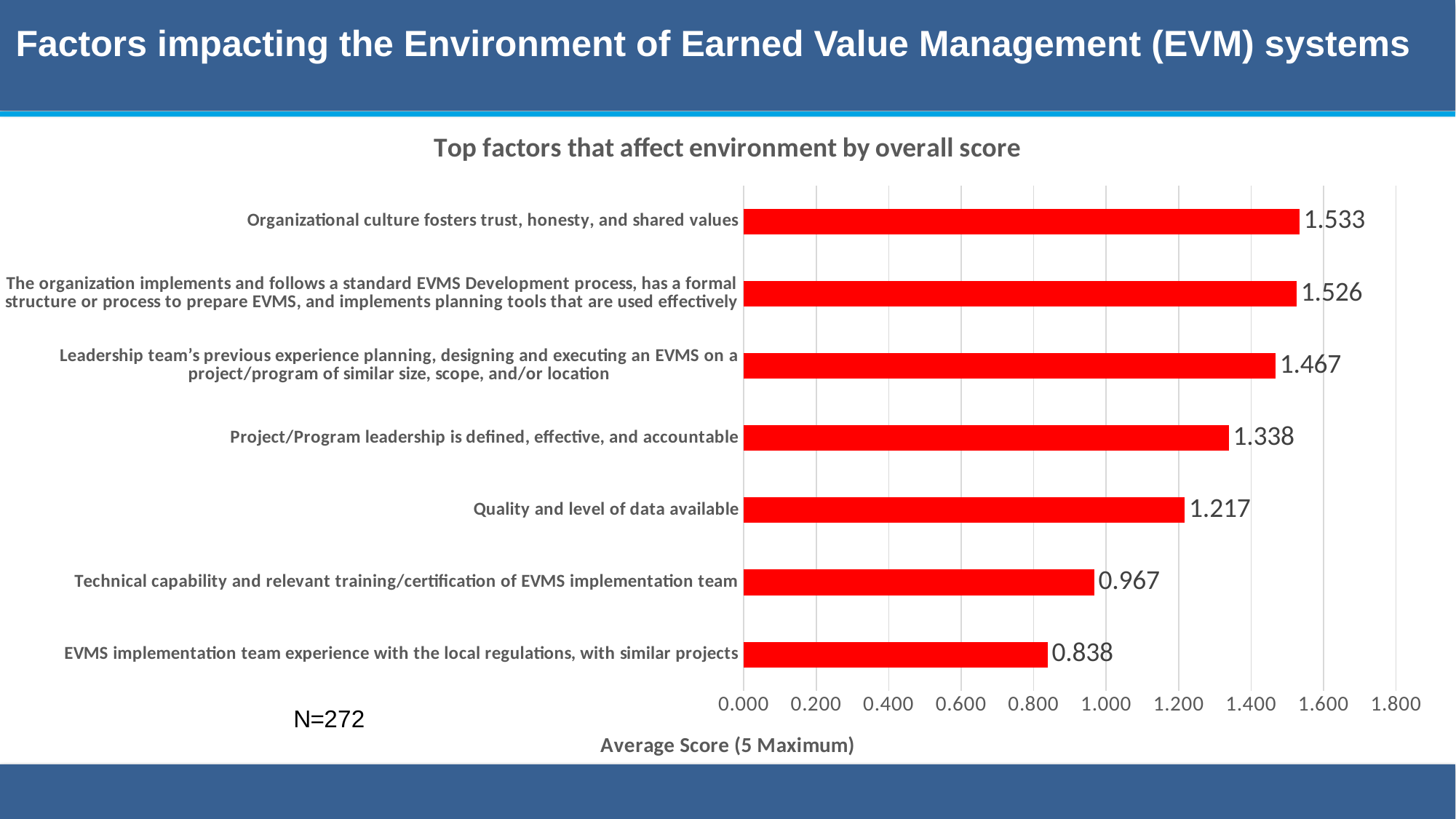
What type of chart is shown on the slide? Bar chart What is the average score for "Technical capability and relevant training/certification of EVMS implementation team"? 0.967 What is the title of the chart? Top factors that affect environment by overall score Which factor has the lowest average score? EVMS implementation team experience with the local regulations, with similar projects Which has a higher average score: "Quality and level of data available" or "Technical capability and relevant training/certification of EVMS implementation team"? Quality and level of data available What is the difference between the scores for "Project/Program leadership is defined, effective, and accountable" and "Quality and level of data available"? 0.121 Is the value for "EVMS implementation team experience with the local regulations, with similar projects" greater or less than 1.000? less What is the average score for "Project/Program leadership is defined, effective, and accountable"? 1.338 What is the difference between the highest score (1.533) and the lowest score (0.838)? 0.695 How many factors are shown in the chart? 7 Which factor has the highest average score? Organizational culture fosters trust, honesty, and shared values What is the average score for "Quality and level of data available"? 1.217